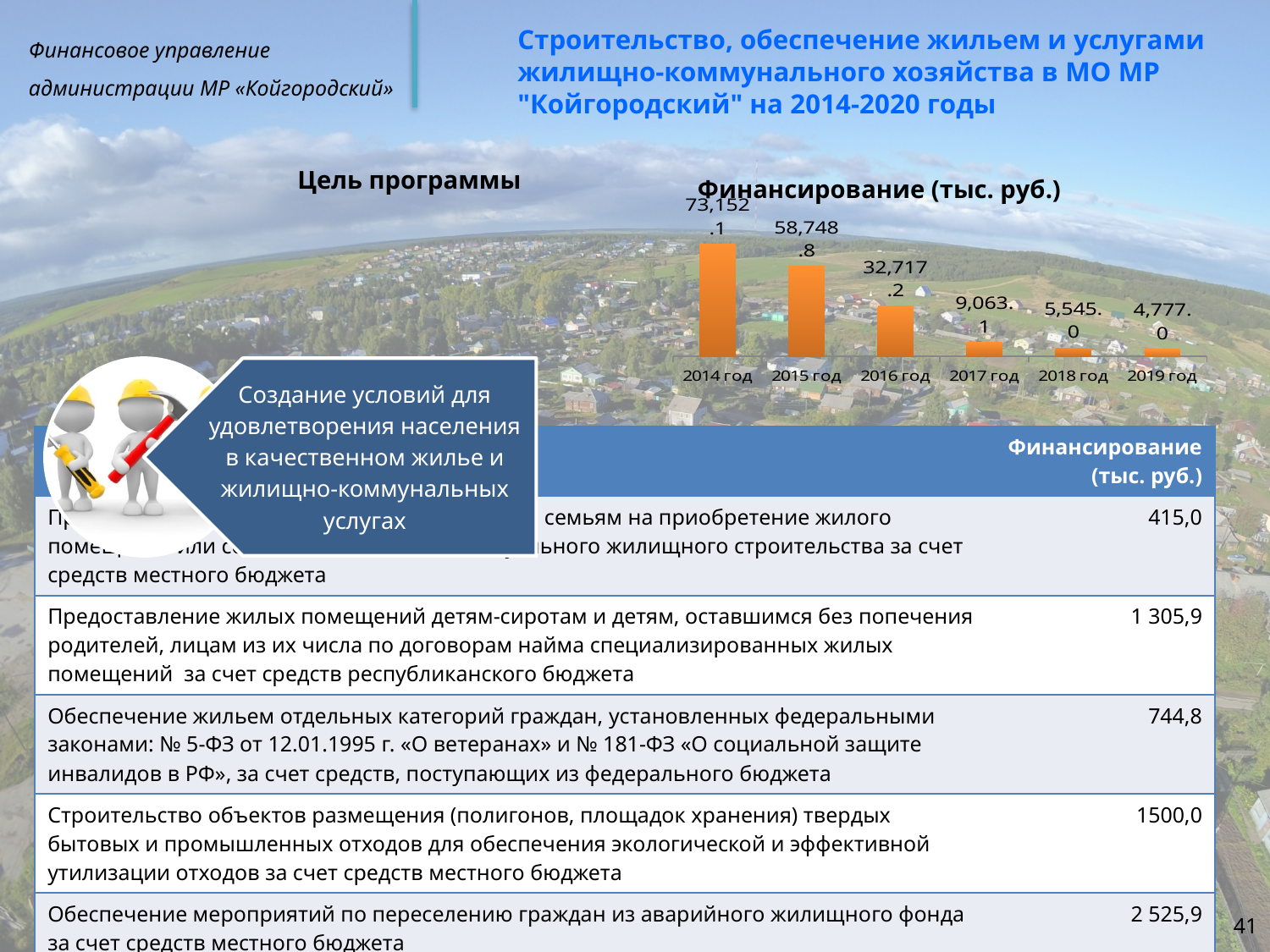
Which year has the highest value in the chart? 2014 год Which is larger in the chart, the value for 2015 год or the value for 2016 год? 2015 год How many years (categories) are shown on the x axis of the chart? 6 What is the value for 2014 год in the chart? 73,152.1 Do the values in the chart rise or fall from 2014 год to 2019 год? fall What is the value for 2016 год in the chart? 32,717.2 What is the value for 2015 год in the chart? 58,748.8 What is the title of the chart on the slide? Финансирование (тыс. руб.) What is the value for 2019 год in the chart? 4,777.0 Which year has the lowest value in the chart? 2019 год What type of chart is shown under the title "Финансирование (тыс. руб.)"? bar chart What is the value for 2017 год in the chart? 9,063.1